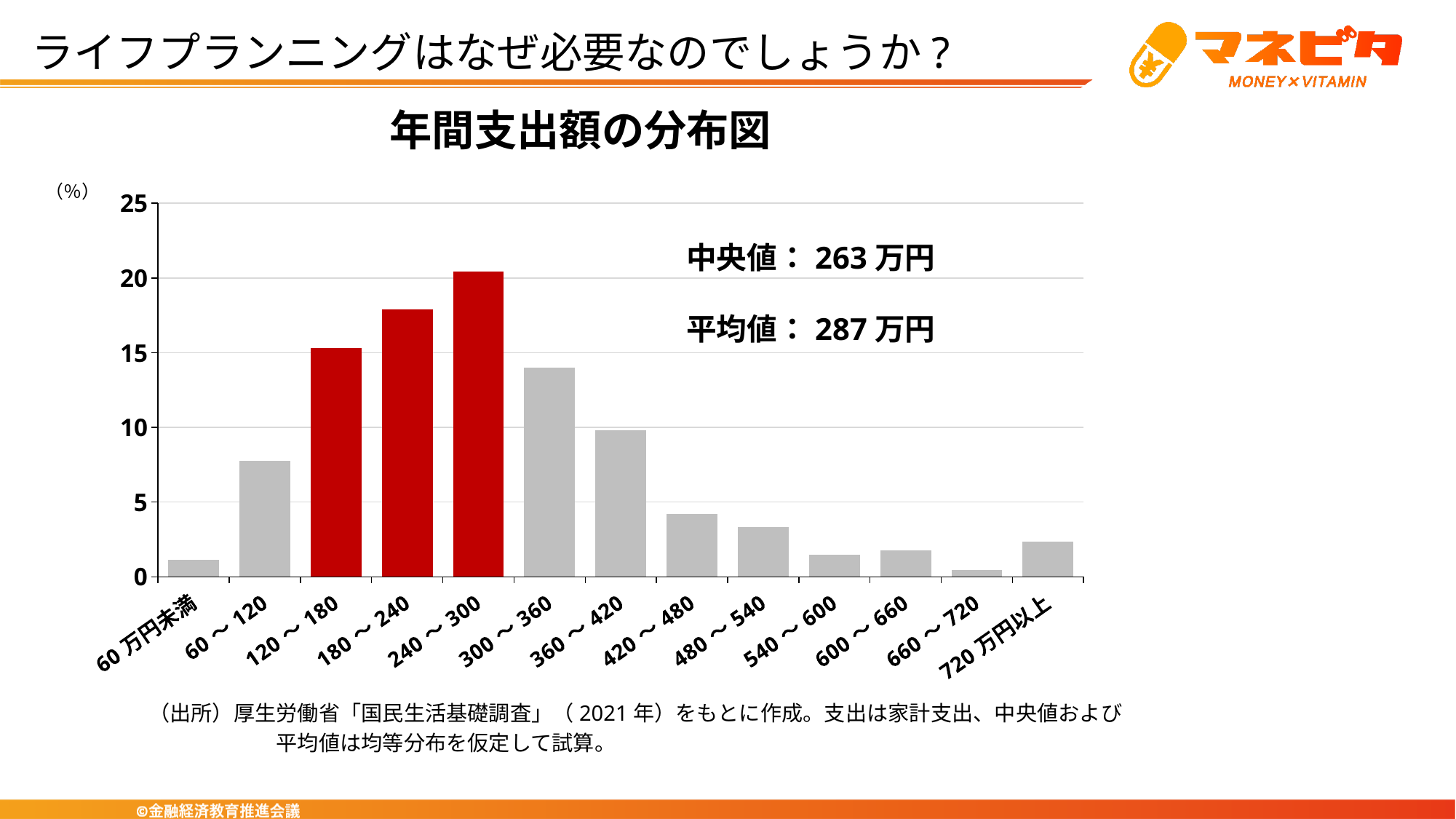
What median value (中央値) is stated on the chart? 263万円 Which category has the highest bar in the chart? 240～300 Which is larger, the value for 180～240 or the value for 300～360? 180～240 Is the value for 300～360 greater or less than 15? less What is the title of the chart? 年間支出額の分布図 How many categories are shown on the x axis of the chart? 13 Which is larger, the value for 60～120 or the value for 420～480? 60～120 What kind of chart is shown on the slide? bar chart Which category has the lowest bar in the chart? 660～720 Is the value for 240～300 greater or less than 20? greater